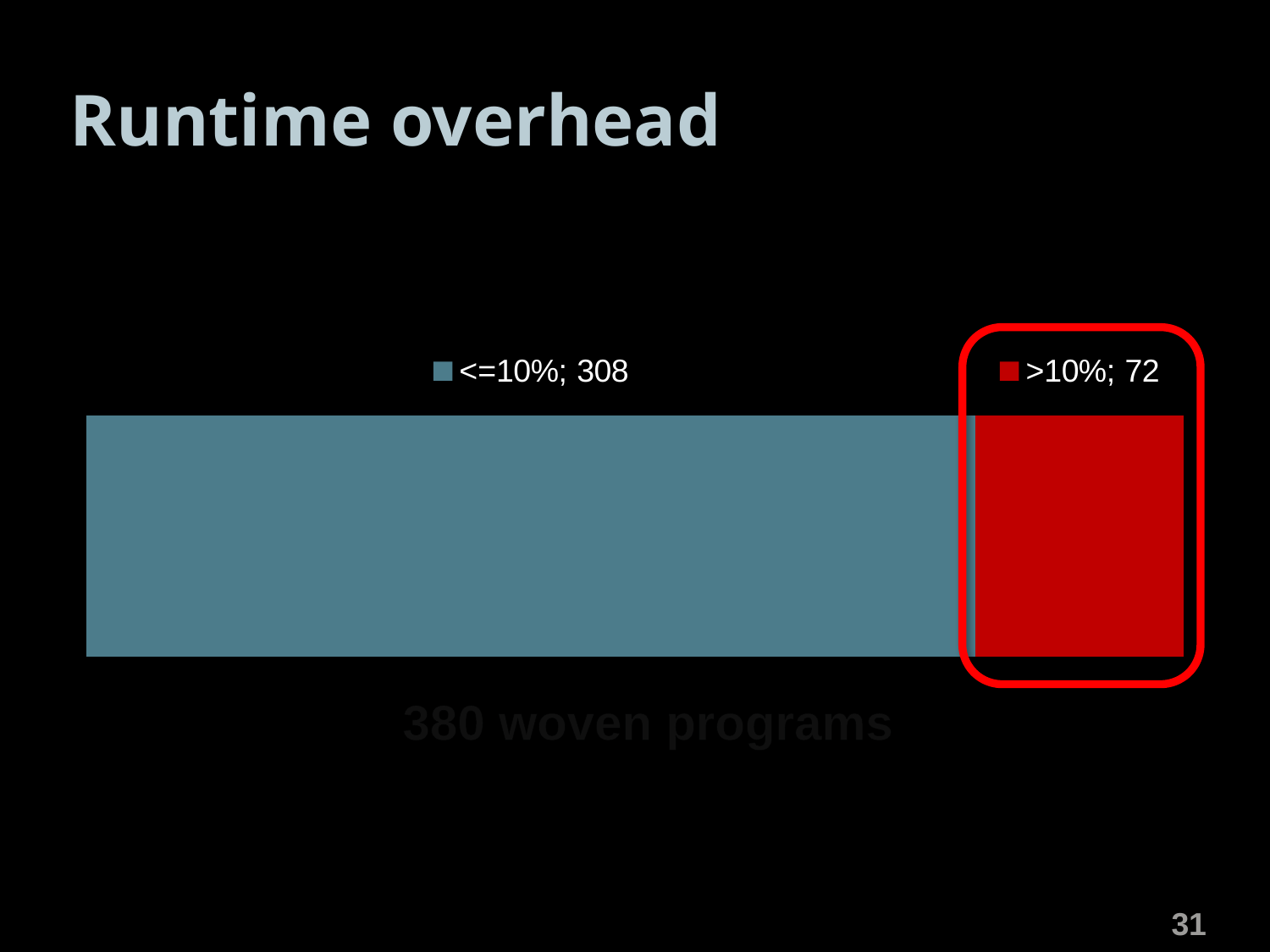
Which segment has the larger value, "<=10%" or ">10%"? <=10% What kind of chart is shown on the slide? Stacked bar chart Which segment is highlighted with a red outline? >10% How many segments make up the stacked bar? 2 What is the title of the slide containing the chart? Runtime overhead What is the value for the "<=10%" segment? 308 Which segment has the largest value? <=10% What is the total of the stacked bar? 380 Which segment has the smallest value? >10% How many series does the legend list? 2 What is the value for the ">10%" segment? 72 What is the difference between the "<=10%" value and the ">10%" value? 236